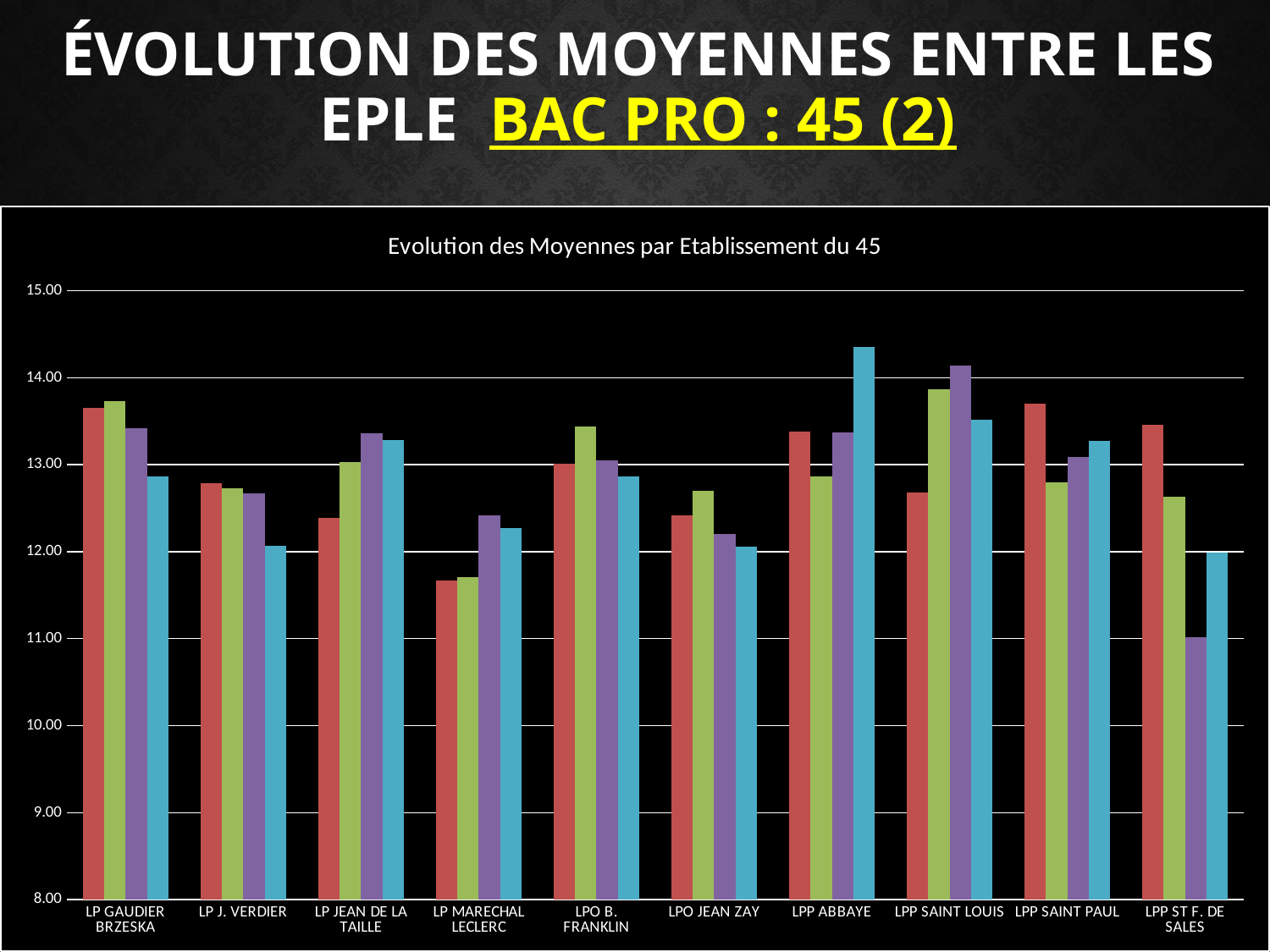
What is the highest value shown on the vertical axis of the chart? 15.00 Which is larger: the green bar for LPP SAINT LOUIS or the green bar for LPP ST F. DE SALES? LPP SAINT LOUIS Is the red bar for LP MARECHAL LECLERC greater or less than 12.00? less How many establishments (categories) are shown on the x axis of the chart? 10 Is the blue bar for LPP ABBAYE greater or less than 14.00? greater Is the red bar for LPP SAINT PAUL greater or less than 13.00? greater Which is larger: the red bar for LP GAUDIER BRZESKA or the red bar for LP J. VERDIER? LP GAUDIER BRZESKA What is the title of the chart? Evolution des Moyennes par Etablissement du 45 Which establishment has the single tallest bar in the chart? LPP ABBAYE What kind of chart is shown on the slide? bar chart Which establishment has the single shortest bar in the chart? LPP ST F. DE SALES